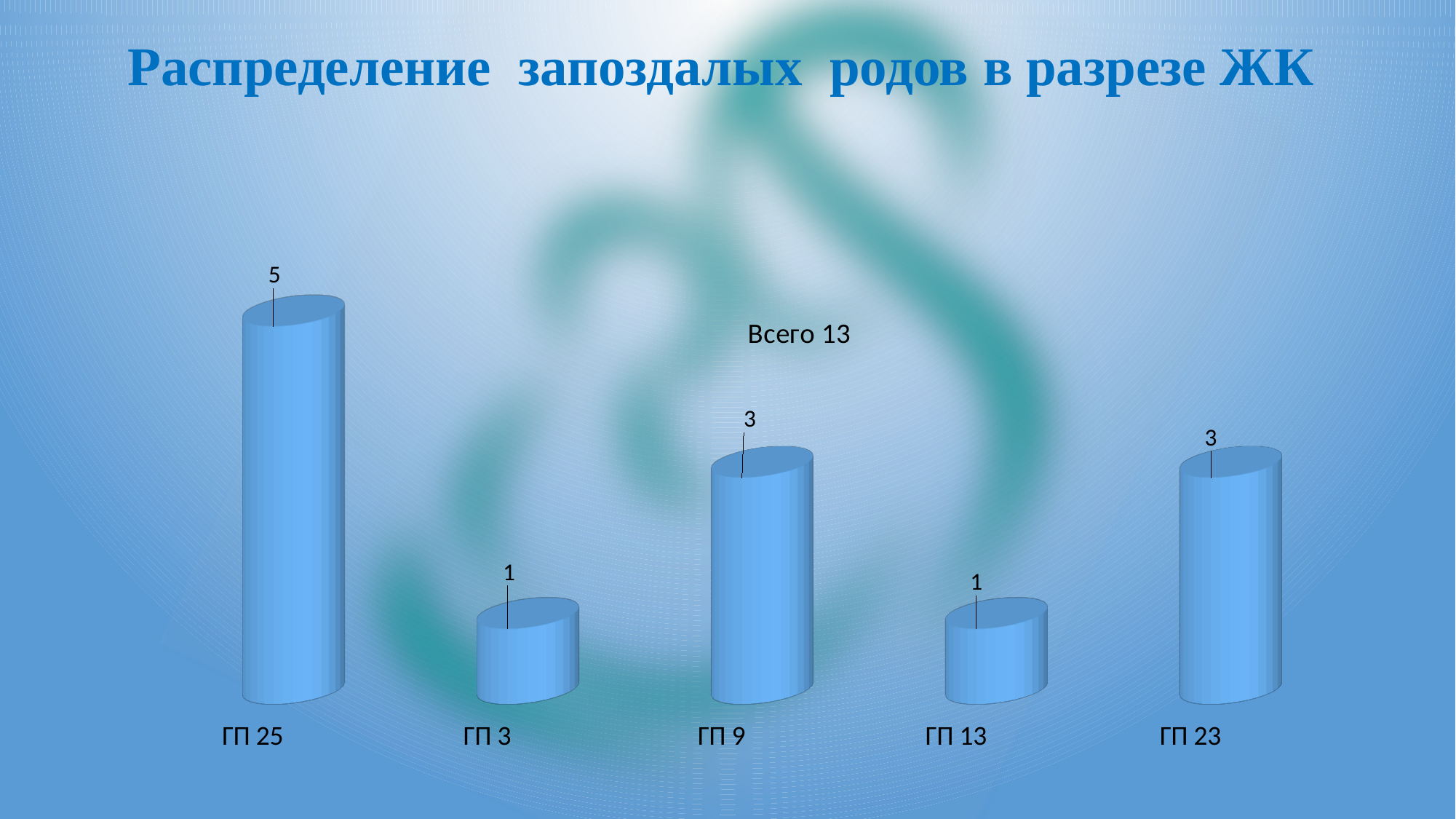
What is the title of the slide? Распределение запоздалых родов в разрезе ЖК What is the value for ГП 25? 5 Which is larger, the value for ГП 23 or the value for ГП 3? ГП 23 Which category has the highest value? ГП 25 What is the difference between the values for ГП 9 and ГП 13? 2 What kind of chart is shown on the slide? bar chart What is the value for ГП 9? 3 How many categories are shown in the chart? 5 What is the value for ГП 13? 1 What is the value for ГП 23? 3 What is the difference between the values for ГП 25 and ГП 3? 4 What total is stated on the chart (Всего)? 13